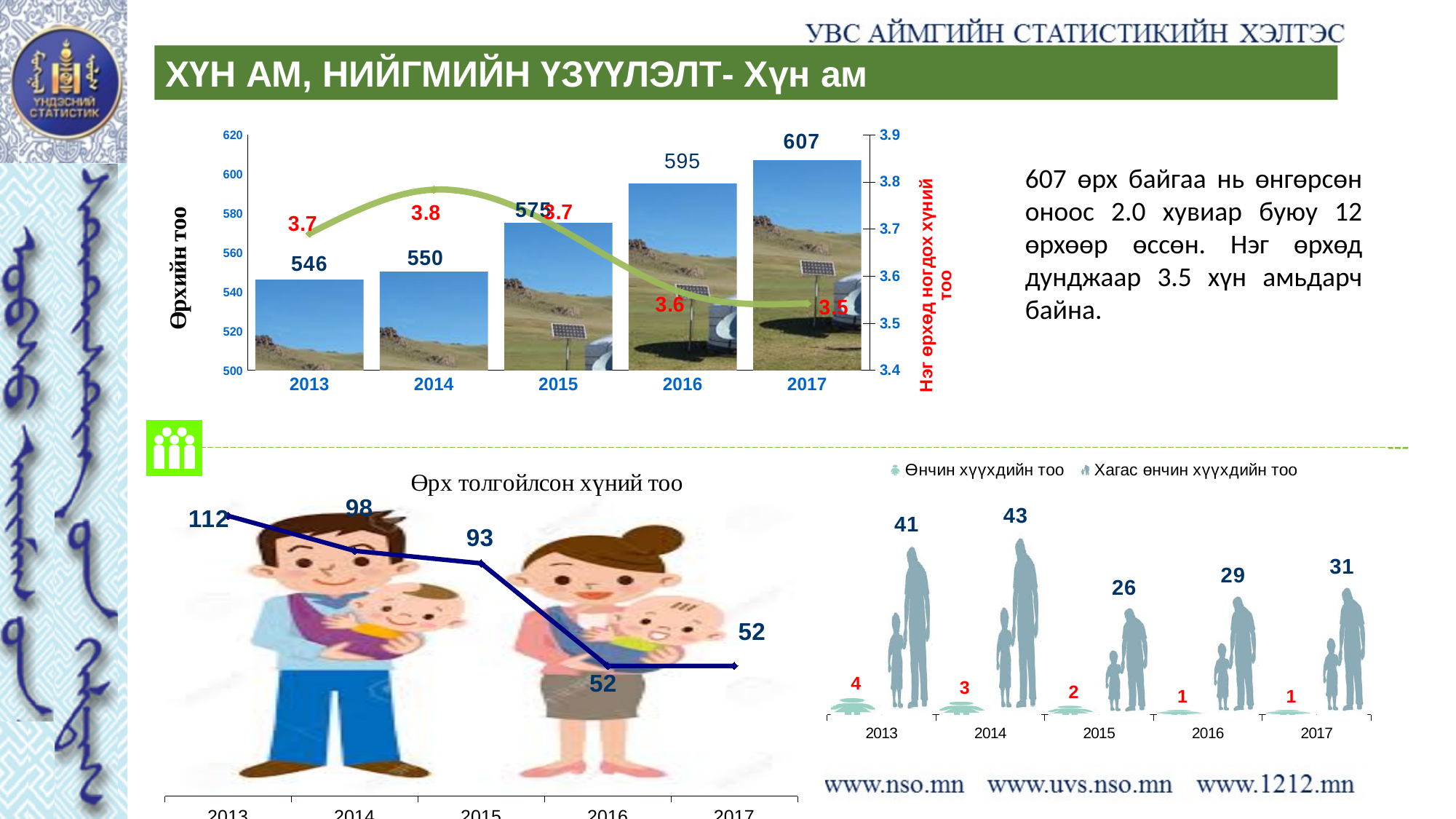
In the bottom-right chart, what is the value of 'Өнчин хүүхдийн тоо' for 2013? 4 In the top chart, which year has the lowest number of households? 2013 In the chart titled 'Өрх толгойлсон хүний тоо', what is the value for 2013? 112 In the chart titled 'Өрх толгойлсон хүний тоо', what is the difference between the 2015 and 2016 values? 41 In the chart titled 'Өрх толгойлсон хүний тоо', how many years are plotted? 5 In the top chart, what is the number of households for 2013? 546 In the top chart, does the line for persons per household rise or fall from 2014 to 2017? fall In the bottom-right chart, how many series does the legend list? 2 In the top chart, by how much did the number of households increase from 2016 to 2017? 12 In the top chart, what is the value of the line (Нэг өрхөд ногдох хүний тоо) for 2014? 3.8 In the top chart, what is the number of households (Өрхийн тоо) for 2017? 607 In the bottom-right chart, what is the value of 'Хагас өнчин хүүхдийн тоо' for 2014? 43